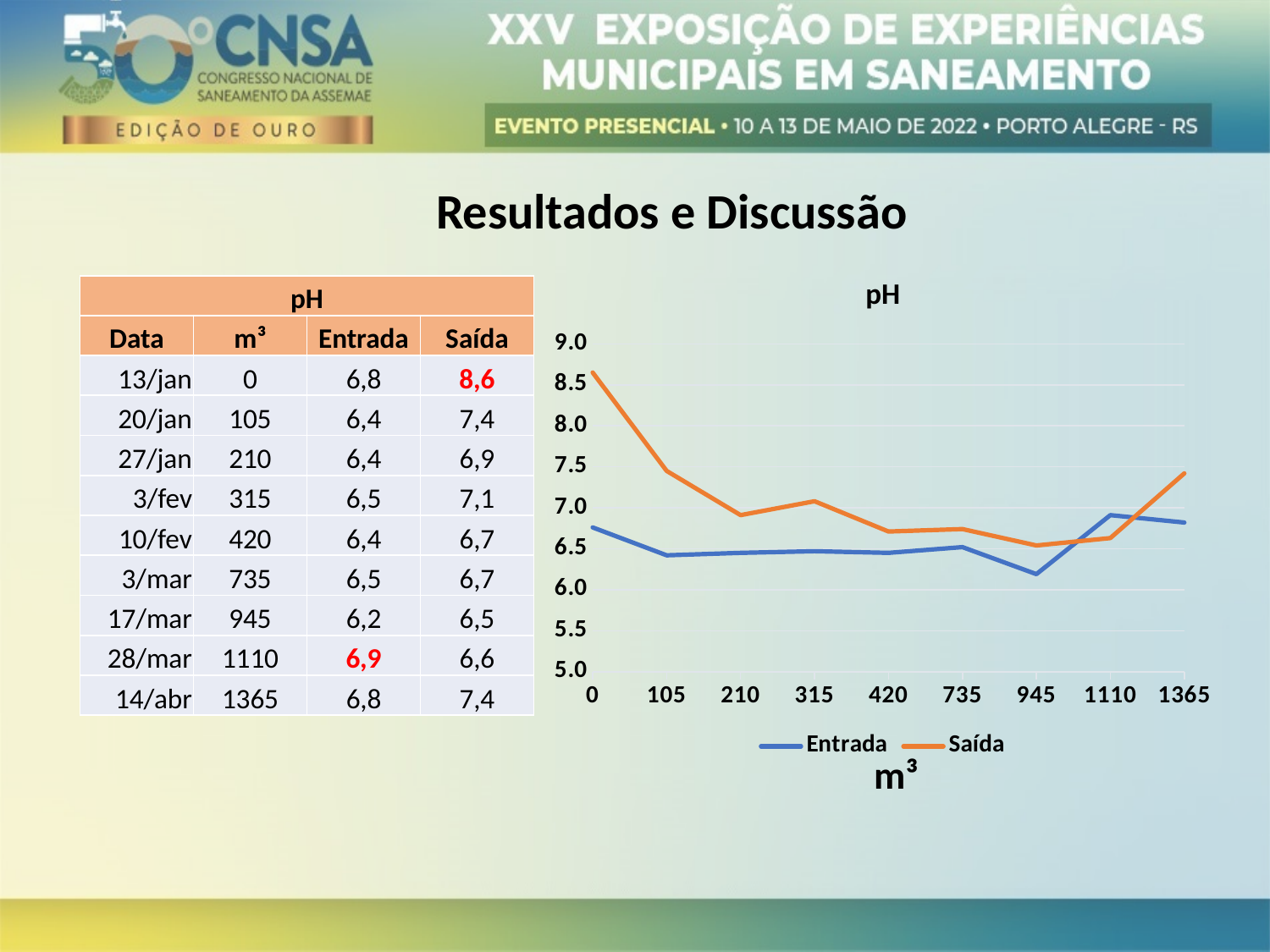
What is the title of the chart? pH Is the Saída pH value at 105 m³ greater or less than 7.0? greater How many points along the x axis does the pH chart have? 9 What is the Entrada pH value at 945 m³? 6,2 Does the Saída pH rise or fall from 0 m³ to 210 m³? fall What is the difference between the Saída and Entrada pH values at 0 m³? 1,8 What is the Saída pH value at 0 m³? 8,6 At which m³ value is the Entrada pH lowest? 945 At 1110 m³, which series has the higher pH, Entrada or Saída? Entrada At which m³ value is the Saída pH highest? 0 How many series does the legend of the pH chart list? 2 What kind of chart is shown on the slide? line chart